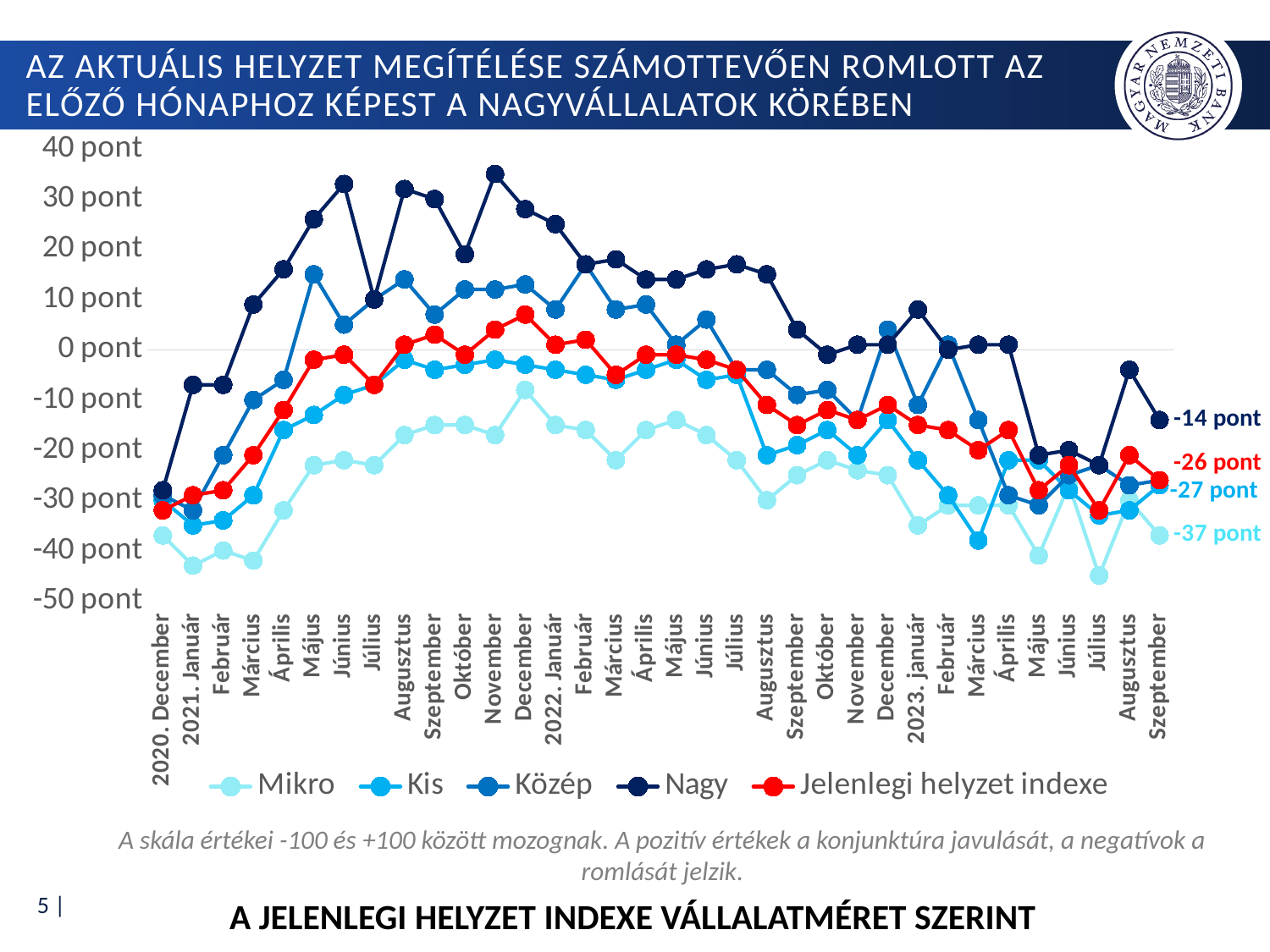
In 2023 Szeptember, which is higher: the Nagy series or the Mikro series? Nagy What kind of chart is shown on the slide? line chart What is the value of the Jelenlegi helyzet indexe series in 2023 Szeptember? -26 pont What is the value of the Mikro series in 2023 Szeptember? -37 pont Is the value of the Mikro series in 2021 Január greater or less than -40 pont? less How many series does the legend list? 5 What is the difference between the Nagy and Mikro values in 2023 Szeptember? 23 pont Which series has the highest value in 2021 November? Nagy What is the value of the Nagy series in 2023 Szeptember? -14 pont Is the value of the Nagy series in 2021 November greater or less than 30 pont? greater Does the Nagy series rise or fall from 2021 November to 2023 Szeptember? fall What are the legend entries of the chart? Mikro, Kis, Közép, Nagy, Jelenlegi helyzet indexe